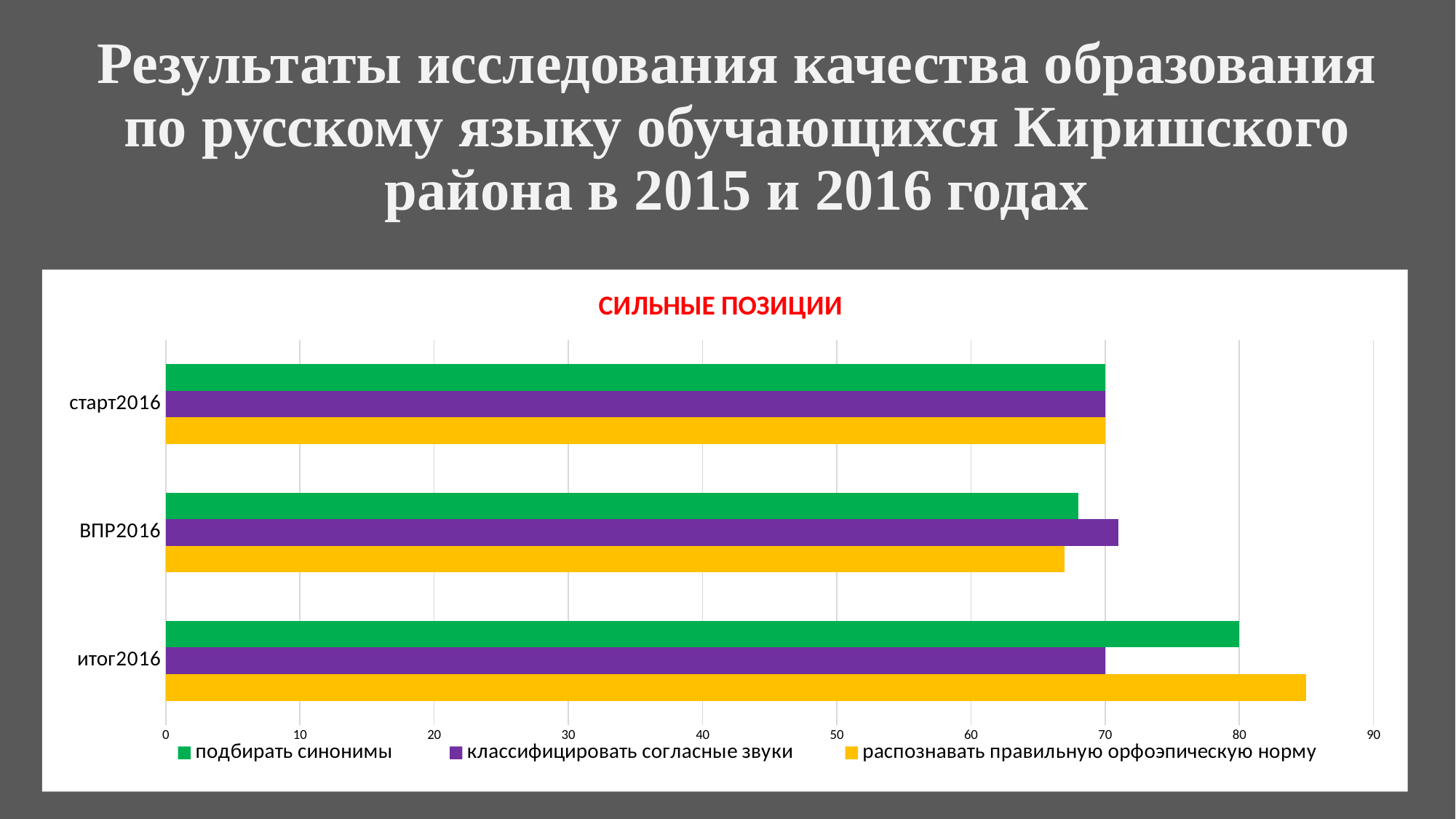
What kind of chart is shown on the slide? bar chart How many categories are shown on the vertical axis? 3 What is the title of the chart? СИЛЬНЫЕ ПОЗИЦИИ How many series does the legend list? 3 Is the value for 'распознавать правильную орфоэпическую норму' in ВПР2016 greater or less than 70? less Which is larger: the value for 'подбирать синонимы' in итог2016 or in ВПР2016? итог2016 What is the value for 'подбирать синонимы' in итог2016? 80 What is the value for 'классифицировать согласные звуки' in итог2016? 70 Which series has the lowest value in ВПР2016? распознавать правильную орфоэпическую норму Is the value for 'распознавать правильную орфоэпическую норму' in итог2016 greater or less than 80? greater Which series has the highest value in итог2016? распознавать правильную орфоэпическую норму What is the value for 'распознавать правильную орфоэпическую норму' in старт2016? 70